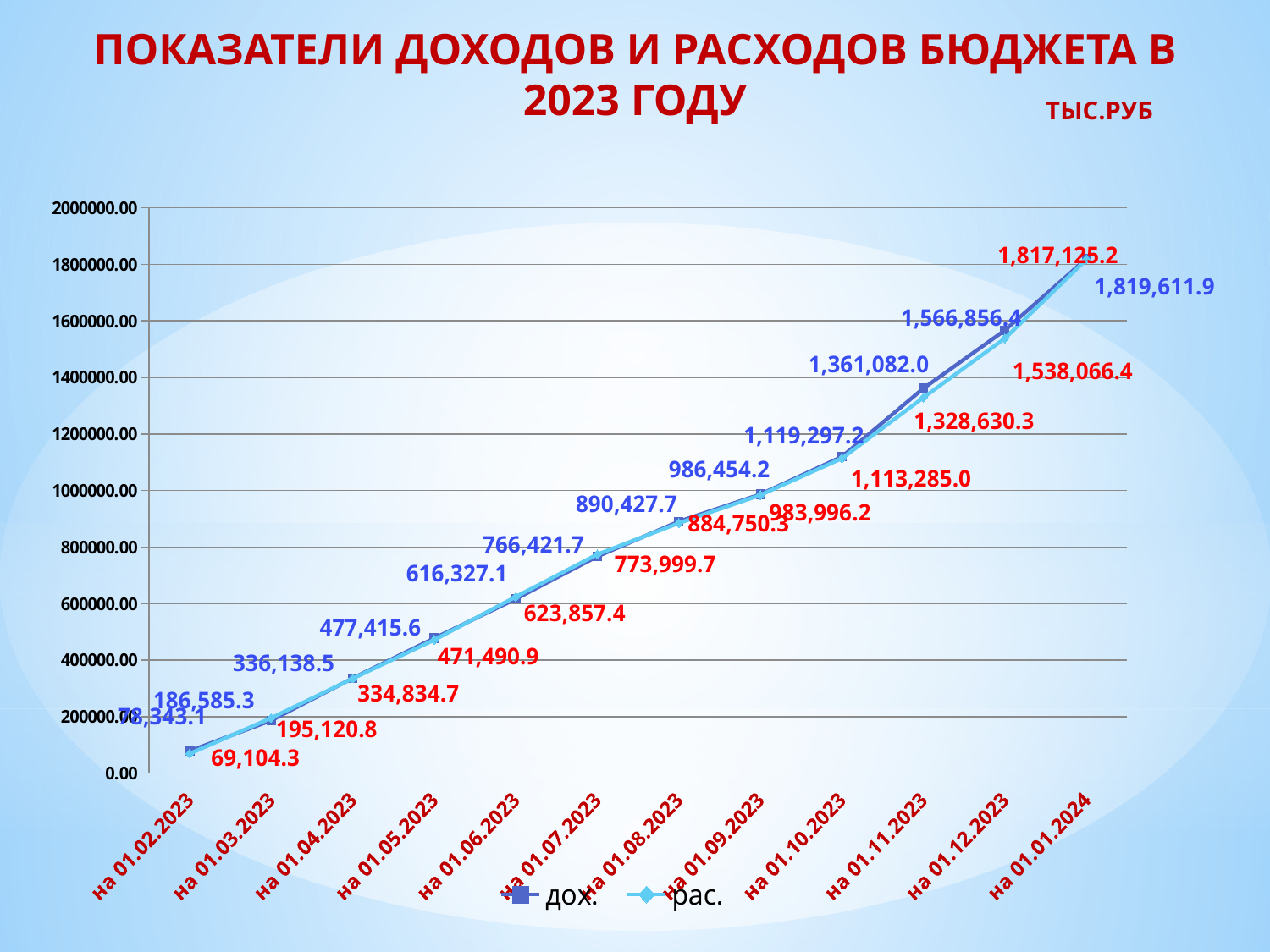
Do the values of the дох. series rise or fall from на 01.02.2023 to на 01.01.2024? rise What kind of chart is shown on the slide? line chart On which date is the дох. series at its highest? на 01.01.2024 What is the value of дох. on на 01.04.2023? 336,138.5 What is the value of рас. on на 01.07.2023? 773,999.7 What is the value of рас. on на 01.01.2024? 1,817,125.2 What is the difference between дох. and рас. on на 01.11.2023? 32,451.7 What is the value of дох. on на 01.10.2023? 1,119,297.2 Which is larger on на 01.06.2023, дох. or рас.? рас. How many series does the legend list? 2 How many dates are shown on the x axis? 12 What is the lowest value of the рас. series? 69,104.3